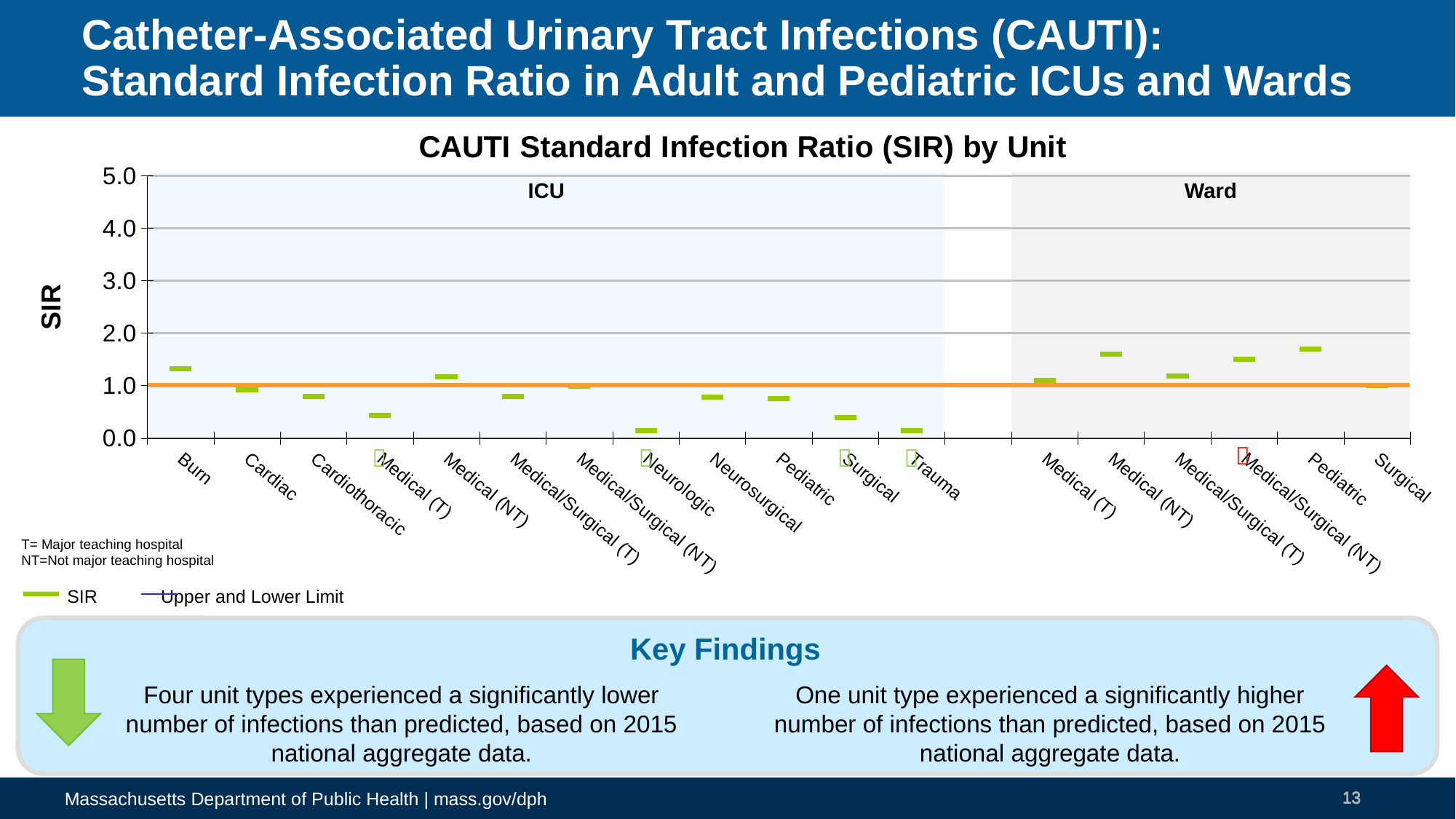
Is the SIR value for the Burn ICU greater or less than 1.0? greater Is the SIR value for the Medical (NT) ward greater or less than 1.0? greater How many unit categories are plotted in the ICU section of the chart? 12 How many entries does the chart legend list? 2 How many unit categories are plotted in the Ward section of the chart? 6 Is the SIR value for the Neurologic ICU greater or less than 1.0? less Which has the higher SIR, the Pediatric ICU or the Pediatric ward? Pediatric ward What is the title of the chart? CAUTI Standard Infection Ratio (SIR) by Unit What label is shown on the vertical axis of the chart? SIR Which has the higher SIR, the Burn ICU or the Cardiothoracic ICU? Burn